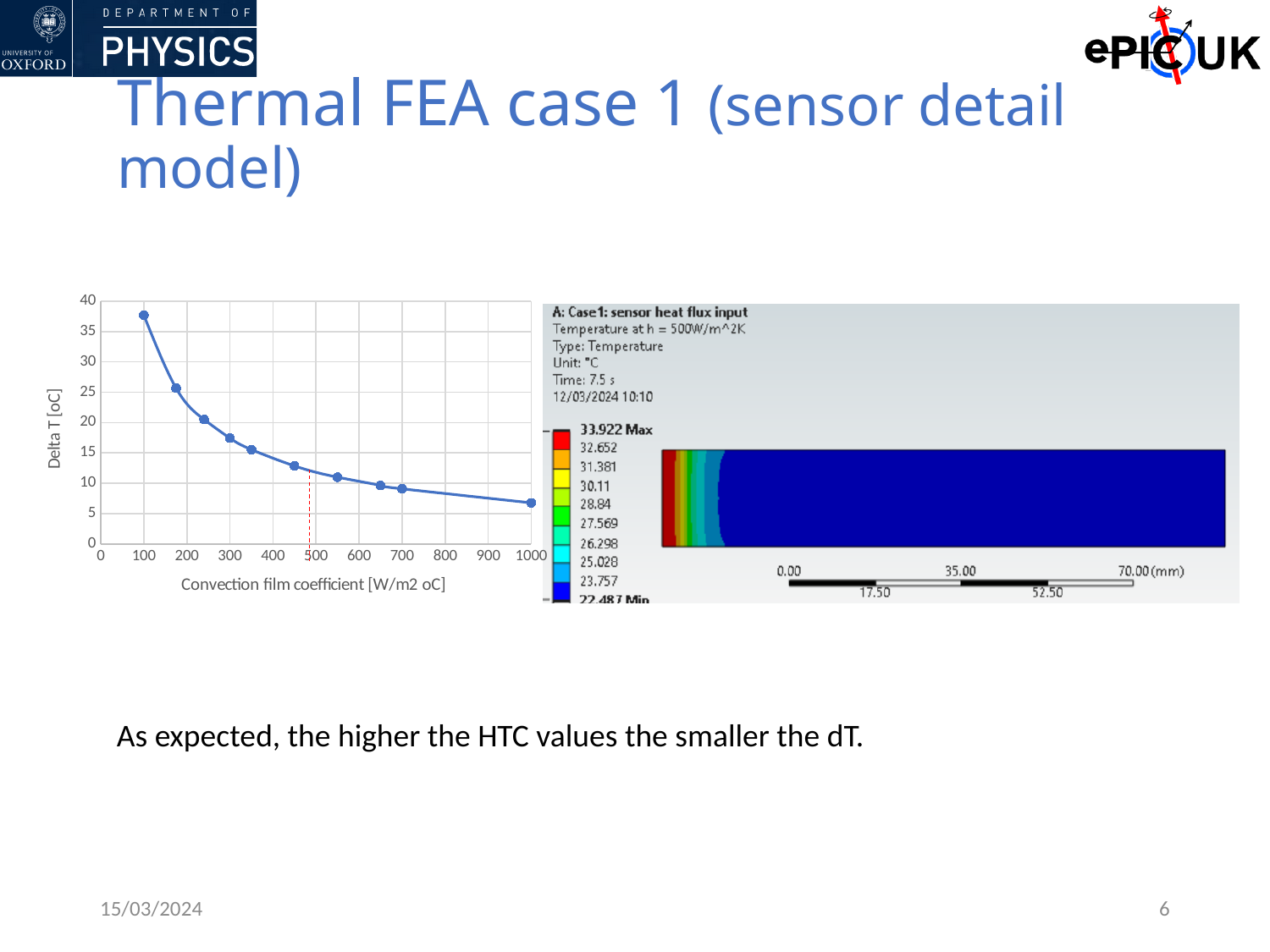
Do the Delta T values rise or fall as the convection film coefficient increases? fall Which has the larger Delta T: a convection film coefficient of 100 or 1000? 100 What is the x-axis title of the Delta T chart? Convection film coefficient [W/m2 oC] Is Delta T at a convection film coefficient of 700 greater or less than 15? less Is Delta T at a convection film coefficient of 100 greater or less than 35? greater At which convection film coefficient is Delta T lowest? 1000 How many data points are plotted on the Delta T chart? 10 Is Delta T at a convection film coefficient of 1000 greater or less than 10? less What is the y-axis title of the chart on the left? Delta T [oC] At which convection film coefficient is Delta T highest? 100 What kind of chart is shown on the left of the slide? line chart